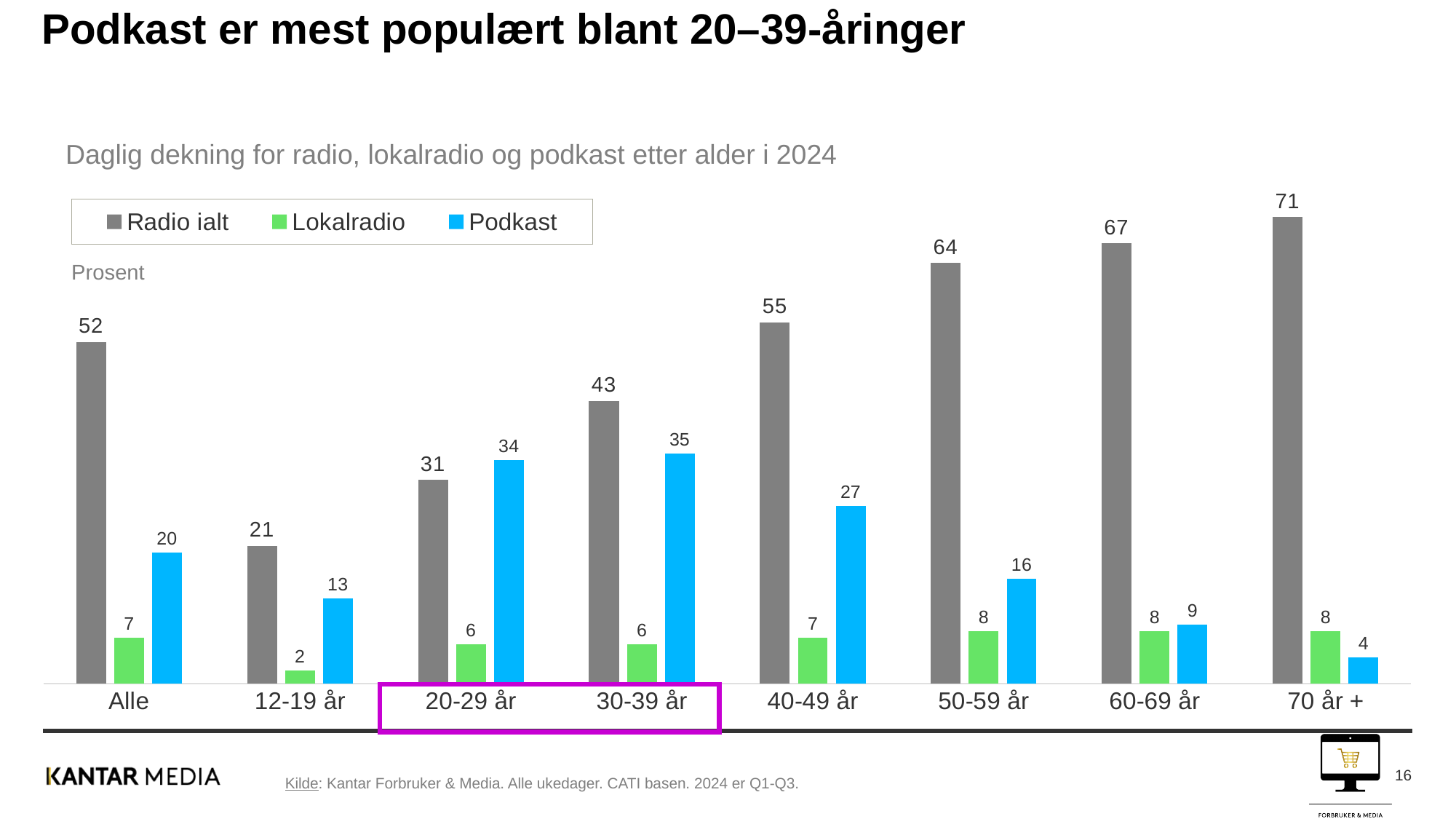
What is the Lokalradio value for the Alle category? 7 Which is larger for the 20-29 år group, Radio ialt or Podkast? Podkast What kind of chart is shown on the slide? Bar chart What is the Podkast value for the 30-39 år group? 35 Which category has the lowest Podkast value? 70 år + What is the Radio ialt value for the 12-19 år group? 21 Which age group has the highest Radio ialt value? 70 år + How many age categories are shown on the x axis? 8 Does the Radio ialt value rise or fall from 12-19 år to 70 år +? Rise How many series does the legend list? 3 What is the difference between the Radio ialt and Podkast values for the 40-49 år group? 28 Which series is shown in blue in the legend? Podkast